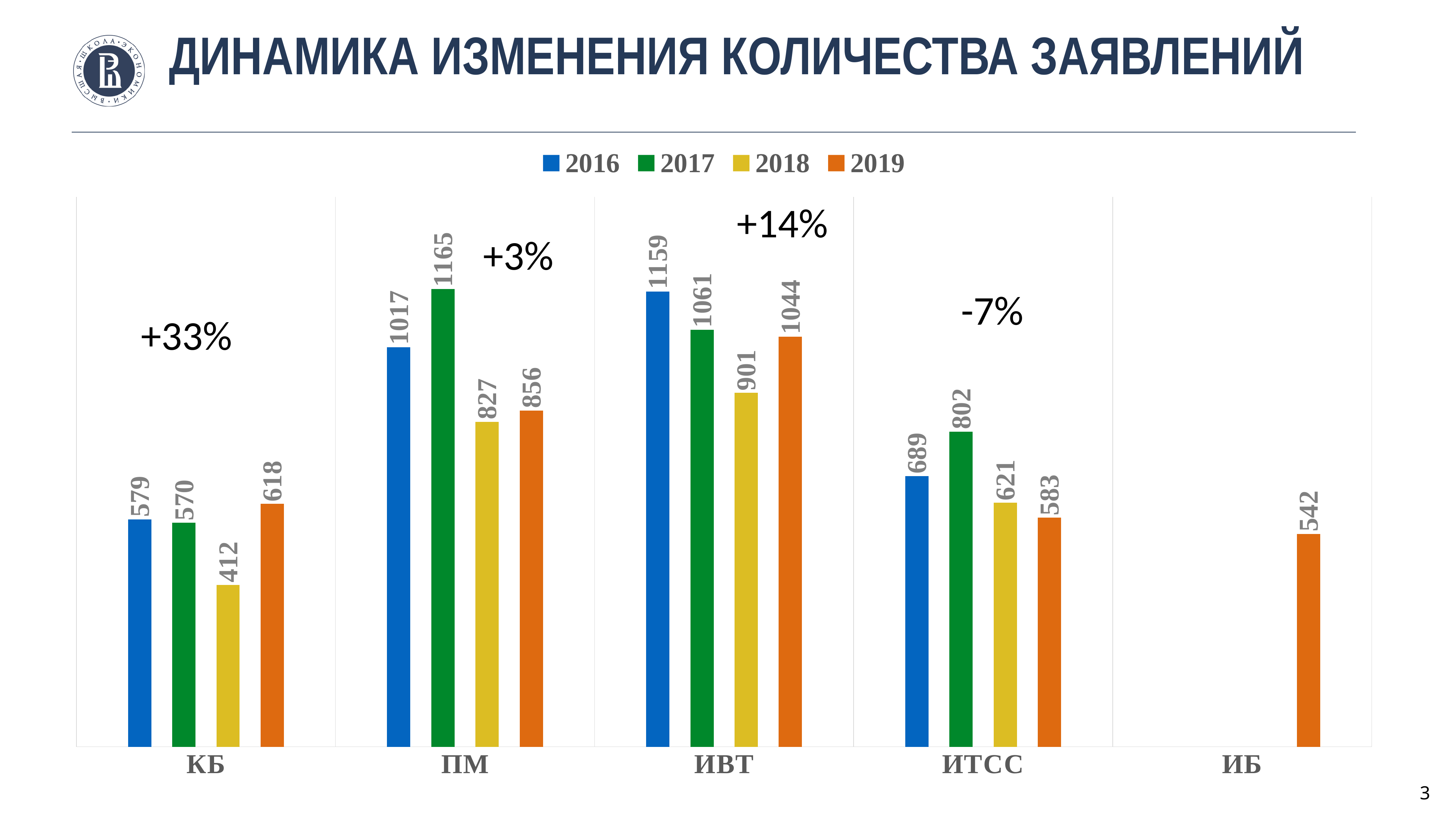
Which category has the lowest value in 2018? КБ What is the value for ИБ in 2019? 542 What is the difference between the 2017 and 2019 values for ИТСС? 219 How many categories are shown on the x axis? 5 What is the value for ПМ in 2017? 1165 How many series does the legend list? 4 What is the difference between the 2019 and 2018 values for КБ? 206 What is the value for КБ in 2018? 412 What kind of chart is shown on the slide? bar chart What percentage change is annotated above the ИТСС group? -7% Which is larger: the 2019 value for ИВТ or the 2019 value for ПМ? ИВТ Which category has the highest value in 2016? ИВТ